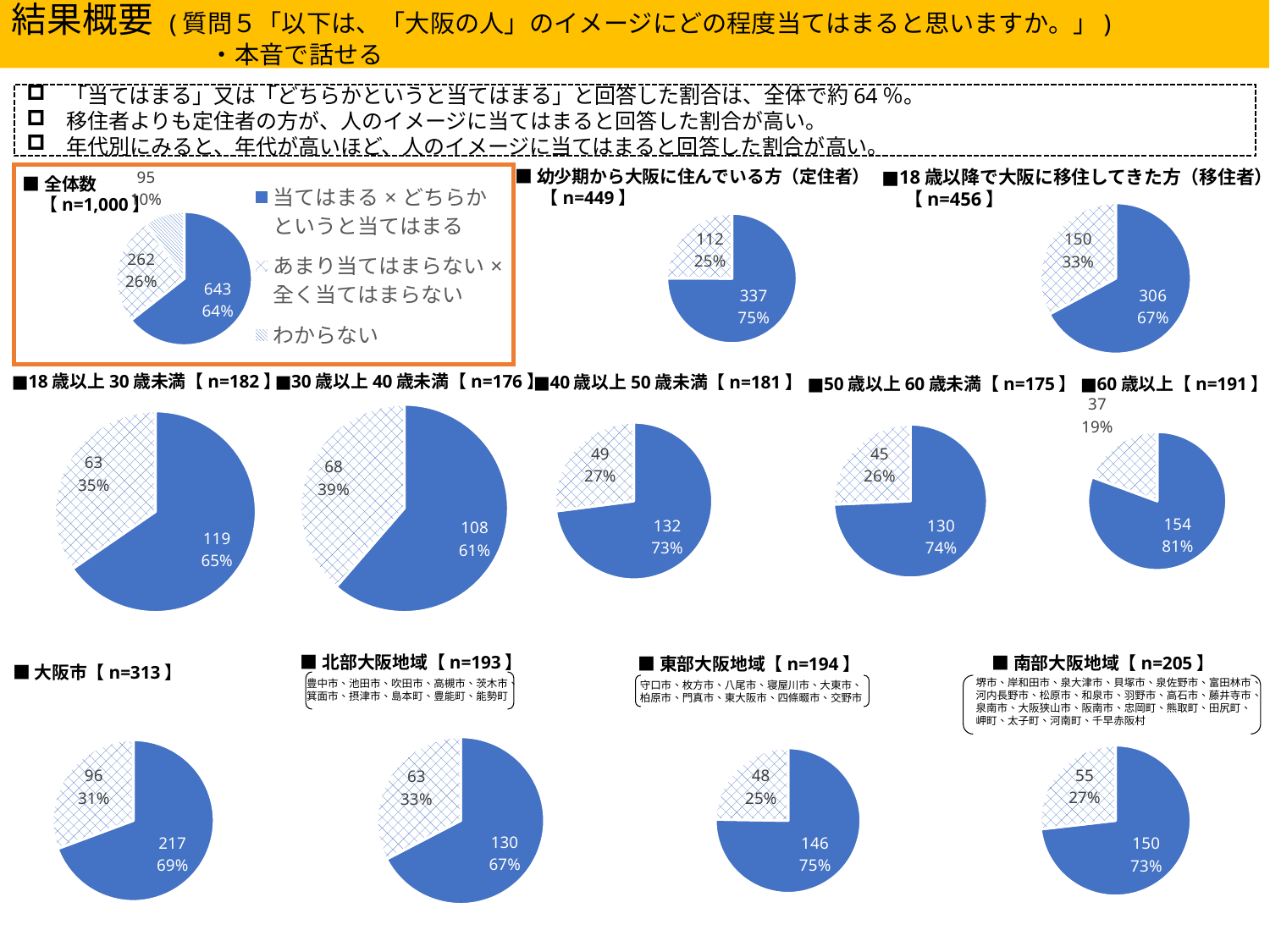
「60歳以上【n=191】」の円グラフで、「当てはまる×どちらかというと当てはまる」の割合は何%ですか。 81% 「18歳以上30歳未満【n=182】」と「40歳以上50歳未満【n=181】」の円グラフで、「当てはまる×どちらかというと当てはまる」の割合が大きいのはどちらですか。 40歳以上50歳未満【n=181】 「東部大阪地域【n=194】」の円グラフで、「当てはまる×どちらかというと当てはまる」の値はいくつですか。 146 「全体数【n=1,000】」の円グラフの凡例には、いくつの項目がありますか。 3 「18歳以降で大阪に移住してきた方（移住者）【n=456】」の円グラフで、「あまり当てはまらない×全く当てはまらない」の値はいくつですか。 150 「30歳以上40歳未満【n=176】」の円グラフで、「当てはまる×どちらかというと当てはまる」と「あまり当てはまらない×全く当てはまらない」の値の差はいくつですか。 40 「大阪市【n=313】」の円グラフで、「あまり当てはまらない×全く当てはまらない」の値はいくつですか。 96 「全体数【n=1,000】」の円グラフで、「わからない」の割合は何%ですか。 10% 「南部大阪地域【n=205】」の円グラフで、「あまり当てはまらない×全く当てはまらない」の割合は何%ですか。 27% 「全体数【n=1,000】」の円グラフで、「当てはまる×どちらかというと当てはまる」の値はいくつですか。 643 このスライドのグラフはどの種類のグラフですか。 円グラフ